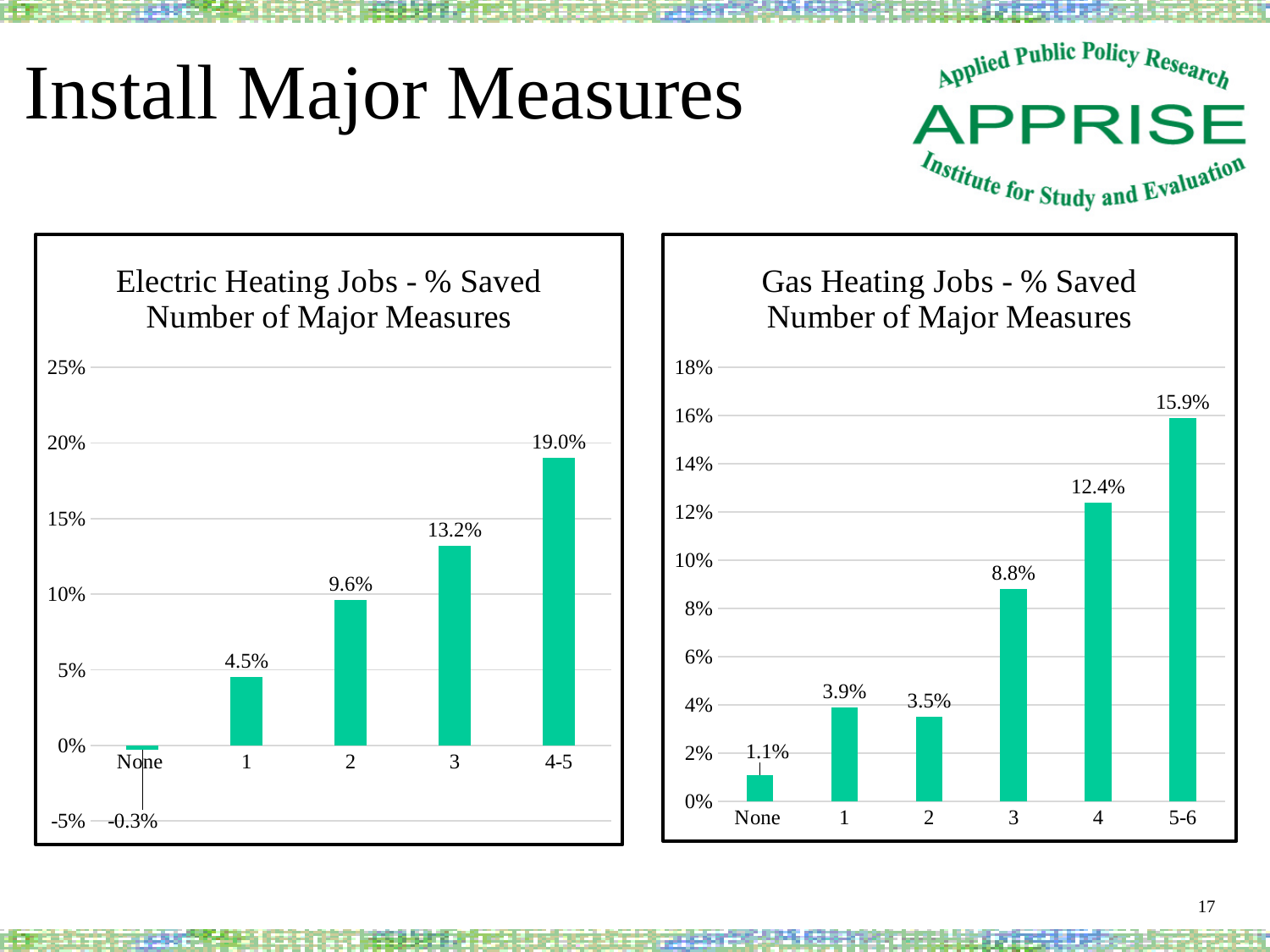
In the Gas Heating Jobs chart, what is the % saved for 3 major measures? 8.8% What kind of chart is the Electric Heating Jobs chart? Bar chart In the Electric Heating Jobs chart, what is the difference in % saved between 4-5 and 3 major measures? 5.8% In the Electric Heating Jobs chart, which category has the lowest % saved? None In the Gas Heating Jobs chart, which category has the highest % saved? 5-6 In the Electric Heating Jobs chart, what is the % saved for 2 major measures? 9.6% In the Electric Heating Jobs chart, what is the % saved for None? -0.3% In the Gas Heating Jobs chart, what is the difference in % saved between 4 and 3 major measures? 3.6% How many categories are shown on the x axis of the Electric Heating Jobs chart? 5 In the Gas Heating Jobs chart, which has a higher % saved: 1 major measure or 2 major measures? 1 In the Electric Heating Jobs chart, do the values rise or fall as the number of major measures increases? Rise How many categories are shown on the x axis of the Gas Heating Jobs chart? 6